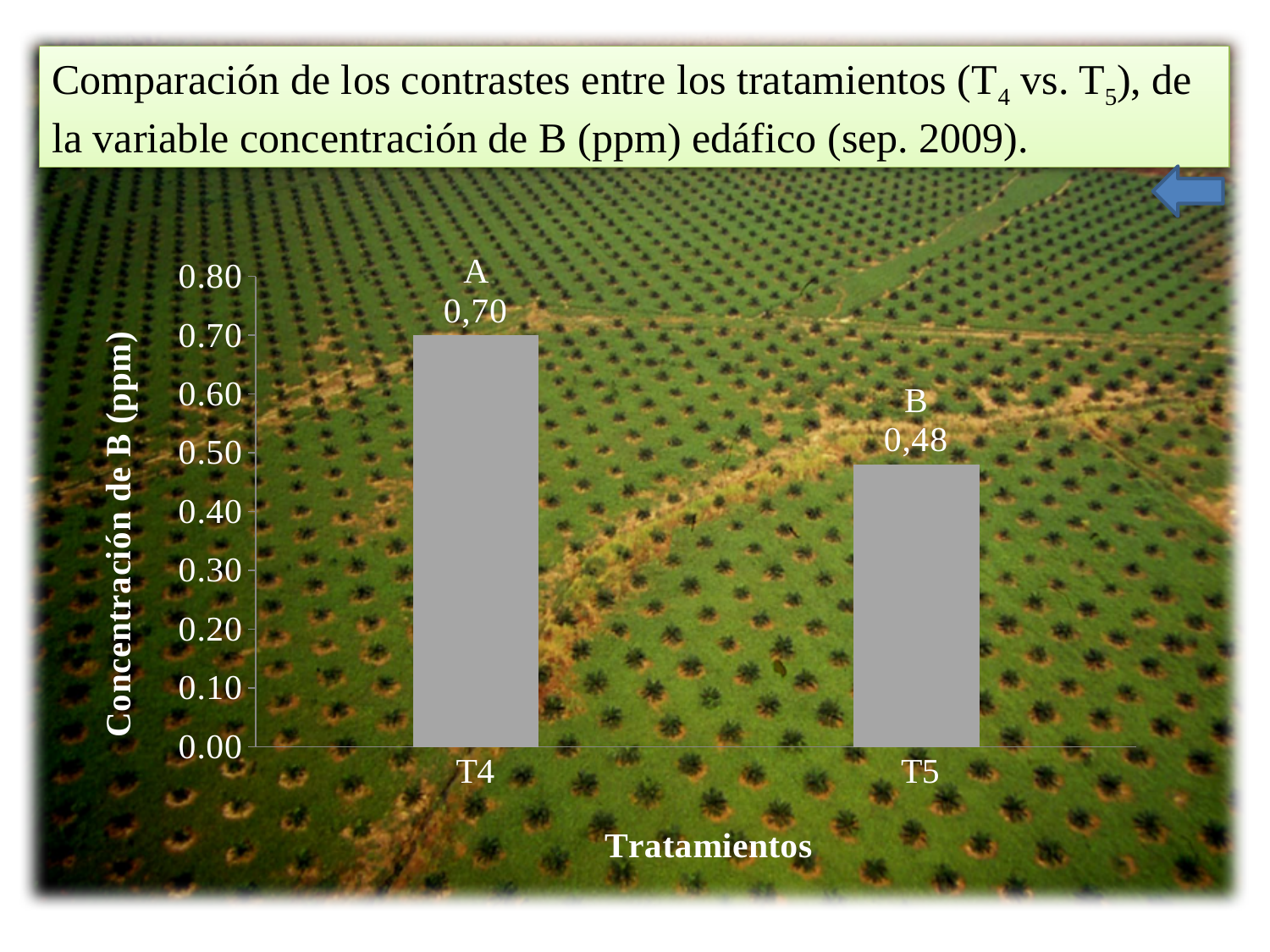
What is the B concentration value for treatment T4? 0,70 What kind of chart is shown on the slide? bar chart What is the label of the y axis? Concentración de B (ppm) Which treatment has the lowest B concentration? T5 Is the value for T4 greater or less than 0.60? greater What is the difference in B concentration between T4 and T5? 0,22 Which treatment has the highest B concentration? T4 Is the value for T5 greater or less than 0.50? less Which treatment has a larger B concentration, T4 or T5? T4 How many treatments are shown on the chart? 2 What statistical group letter is shown above the T5 bar? B What is the B concentration value for treatment T5? 0,48